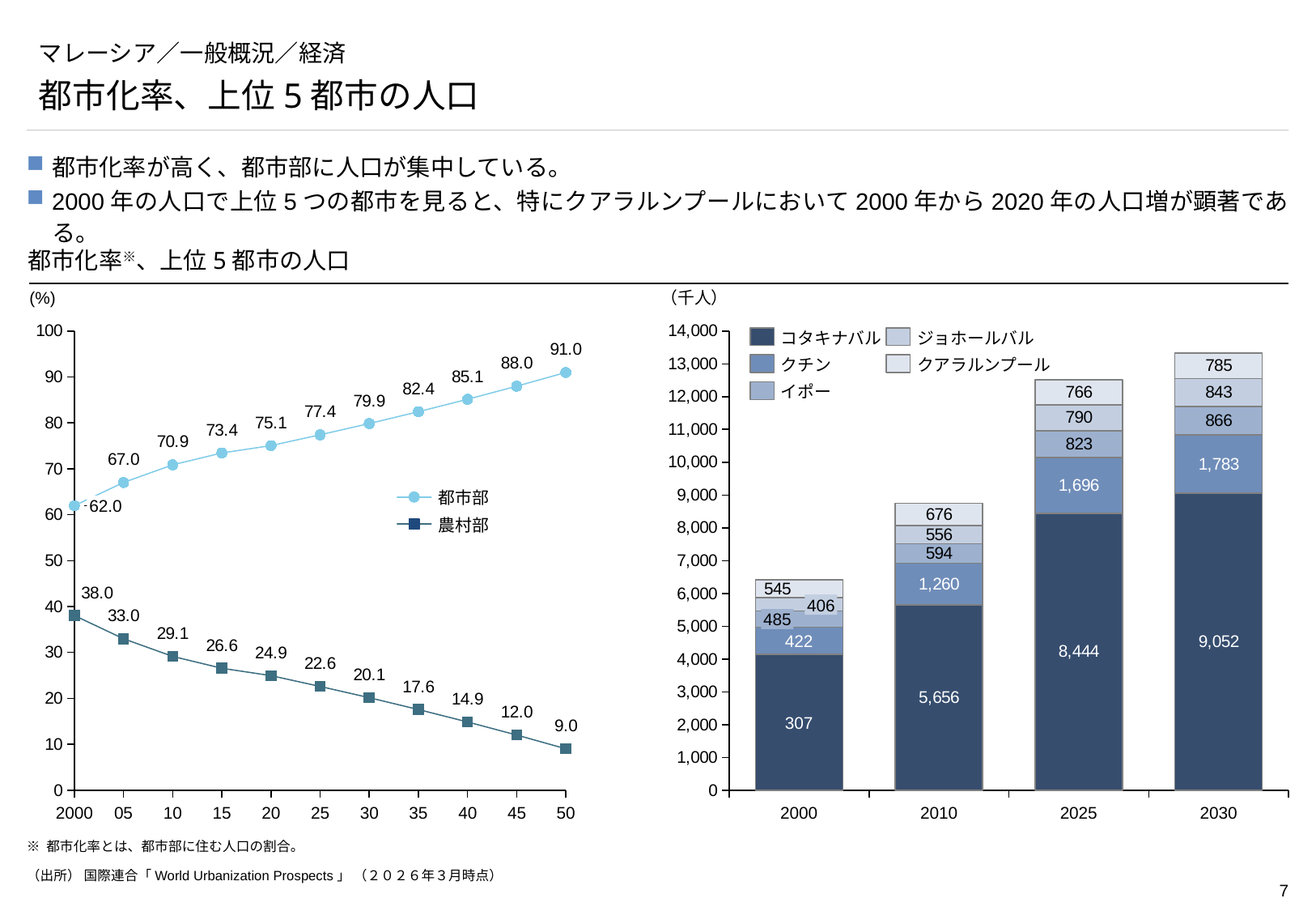
In the left chart, what is the difference between the 都市部 and 農村部 values in 2050? 82.0 In the left chart, what is the 農村部 value for 2020? 24.9 How many series does the legend of the right chart list? 5 In the left chart, does the 農村部 line rise or fall from 2000 to 2050? fall How many bars (years) are shown in the right chart? 4 In the right chart, what is the total of the 2030 stacked bar? 13,329 What kind of chart is the right chart (上位5都市の人口)? stacked bar chart In the left chart, what is the 都市部 value for 2030? 79.9 In the right chart, what is the difference between the bottom segment of the 2030 bar and the bottom segment of the 2025 bar? 608 In the right chart, what is the value of the topmost segment of the 2025 bar? 766 How many series does the legend of the left chart list? 2 What kind of chart is the left chart (都市化率)? line chart